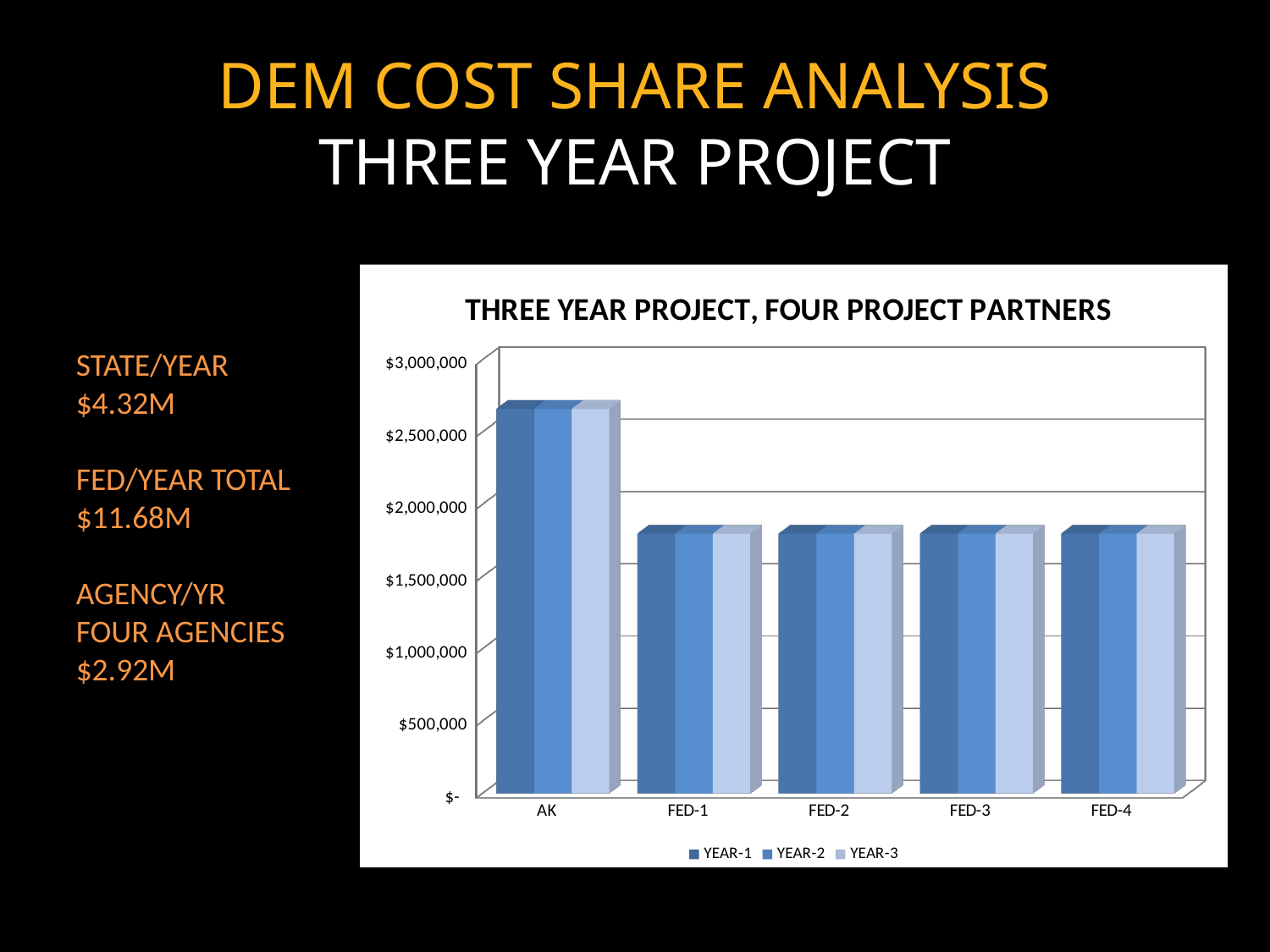
How many series does the chart's legend list? 3 What is the title of the chart? THREE YEAR PROJECT, FOUR PROJECT PARTNERS Is the YEAR-1 value for FED-1 greater or less than $2,000,000? less What kind of chart is shown on the slide? bar chart Is the YEAR-3 value for FED-4 greater or less than $1,500,000? greater Is the YEAR-2 value for AK greater or less than $3,000,000? less Which is larger, the YEAR-1 value for AK or the YEAR-1 value for FED-2? AK How many categories are shown on the x axis of the chart? 5 What are the series names listed in the chart's legend? YEAR-1, YEAR-2, YEAR-3 Which category has the highest bars in the chart? AK